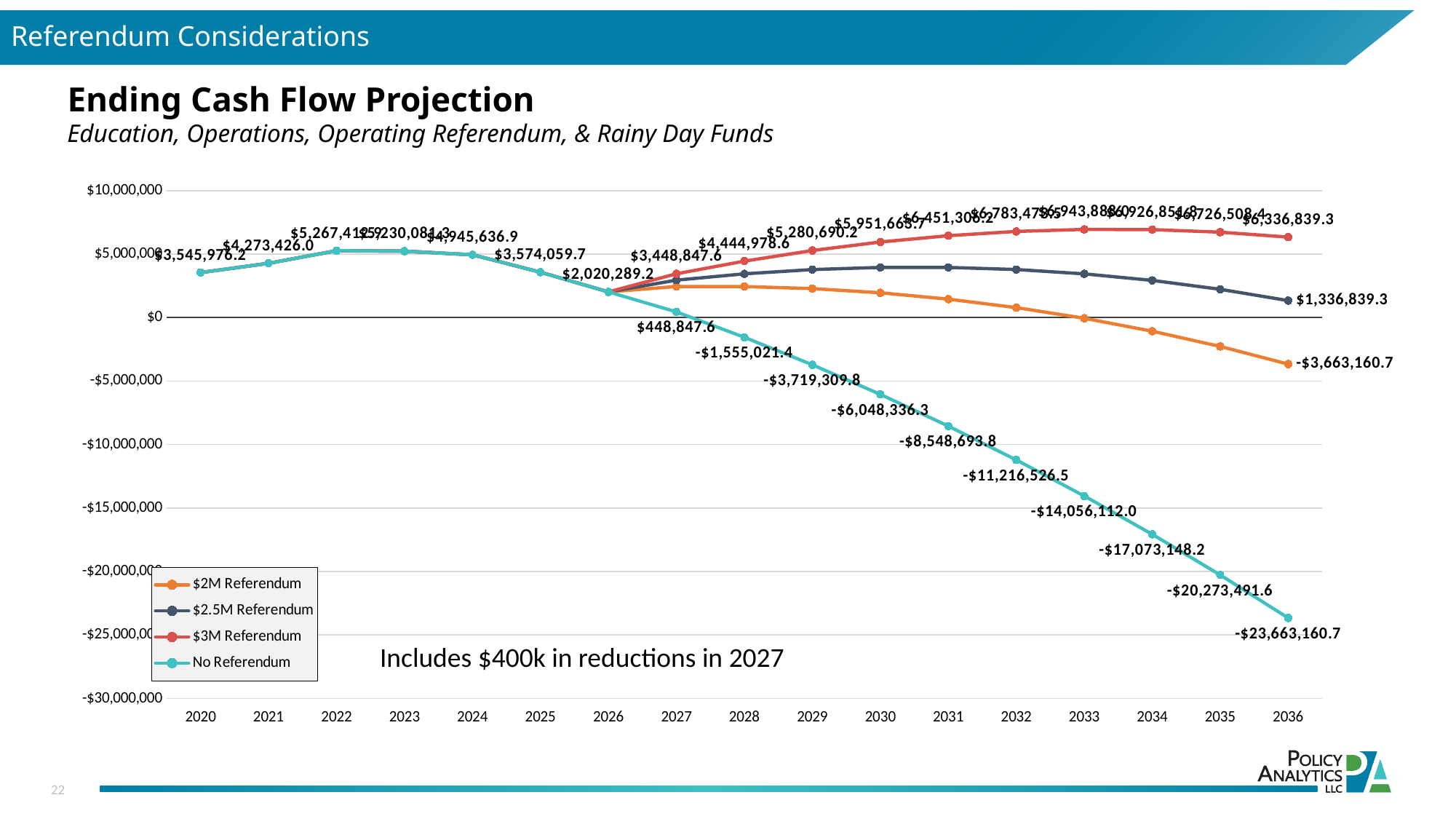
What is the value shown for 2026, where all series meet? $2,020,289.2 What is the No Referendum value in 2036? -$23,663,160.7 Which series has the lowest value in 2036? No Referendum What is the $2.5M Referendum value in 2036? $1,336,839.3 Does the No Referendum series rise or fall from 2026 to 2036? fall How many series does the legend list? 4 What is the difference between the $3M Referendum and $2.5M Referendum values in 2036? $5,000,000.0 What is the No Referendum value in 2031? -$8,548,693.8 What is the $2M Referendum value in 2036? -$3,663,160.7 What is the $3M Referendum value in 2036? $6,336,839.3 How many years are shown on the x axis? 17 What type of chart is shown on the slide? line chart